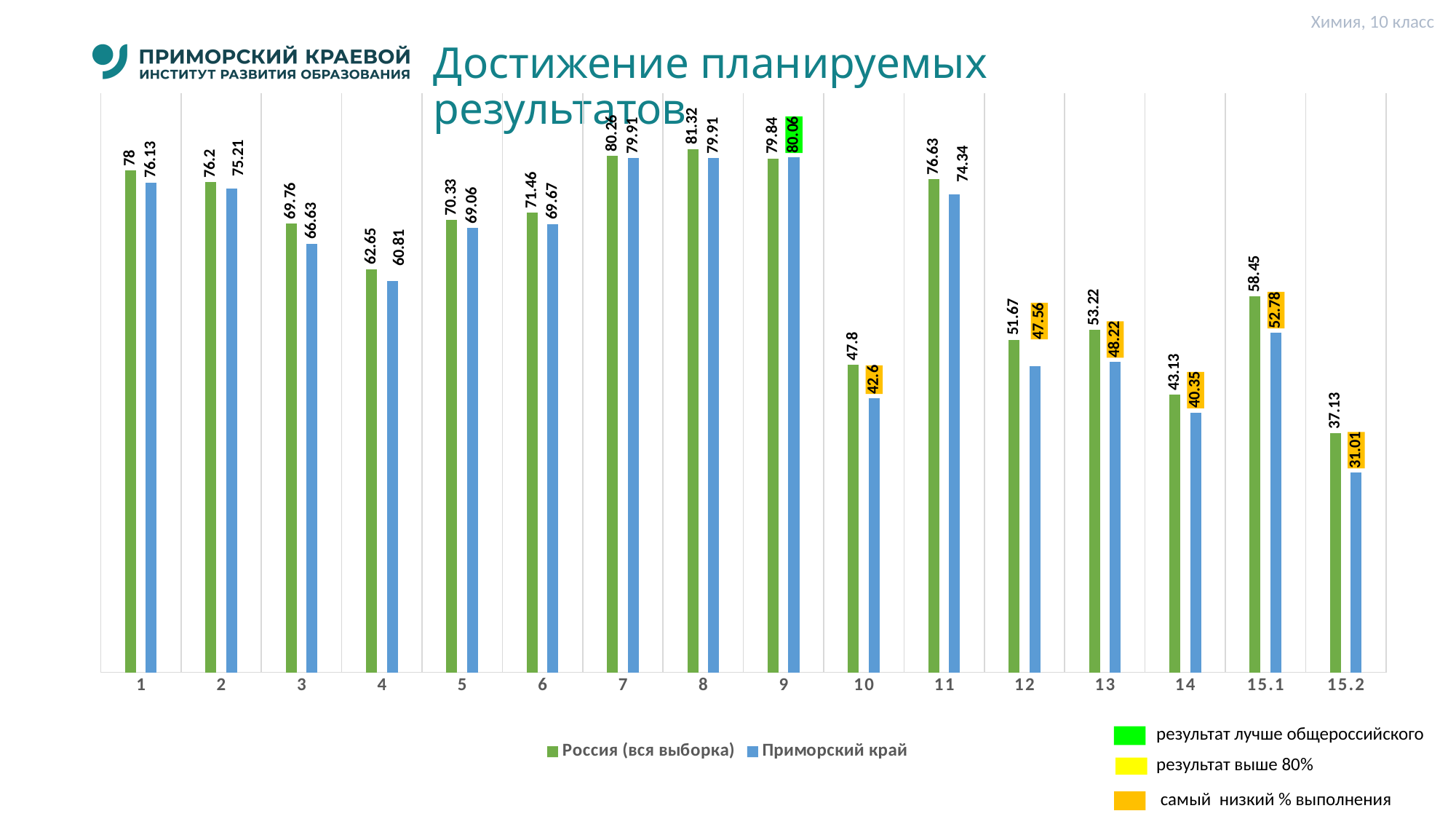
How many tasks (categories) are shown on the x axis? 16 What is the title of the chart? Достижение планируемых результатов How many series does the chart legend list? 2 What is the value for Приморский край for task 15.1? 52.78 For task 9, which series has the larger value: Россия (вся выборка) or Приморский край? Приморский край What is the difference between Россия (вся выборка) and Приморский край for task 15.2? 6.12 What is the value for Приморский край for task 10? 42.6 Which task has the lowest value for Приморский край? 15.2 What is the difference between Россия (вся выборка) and Приморский край for task 10? 5.2 What kind of chart is shown on the slide? Bar chart Which task has the highest value for Россия (вся выборка)? 8 What is the value for Россия (вся выборка) for task 1? 78